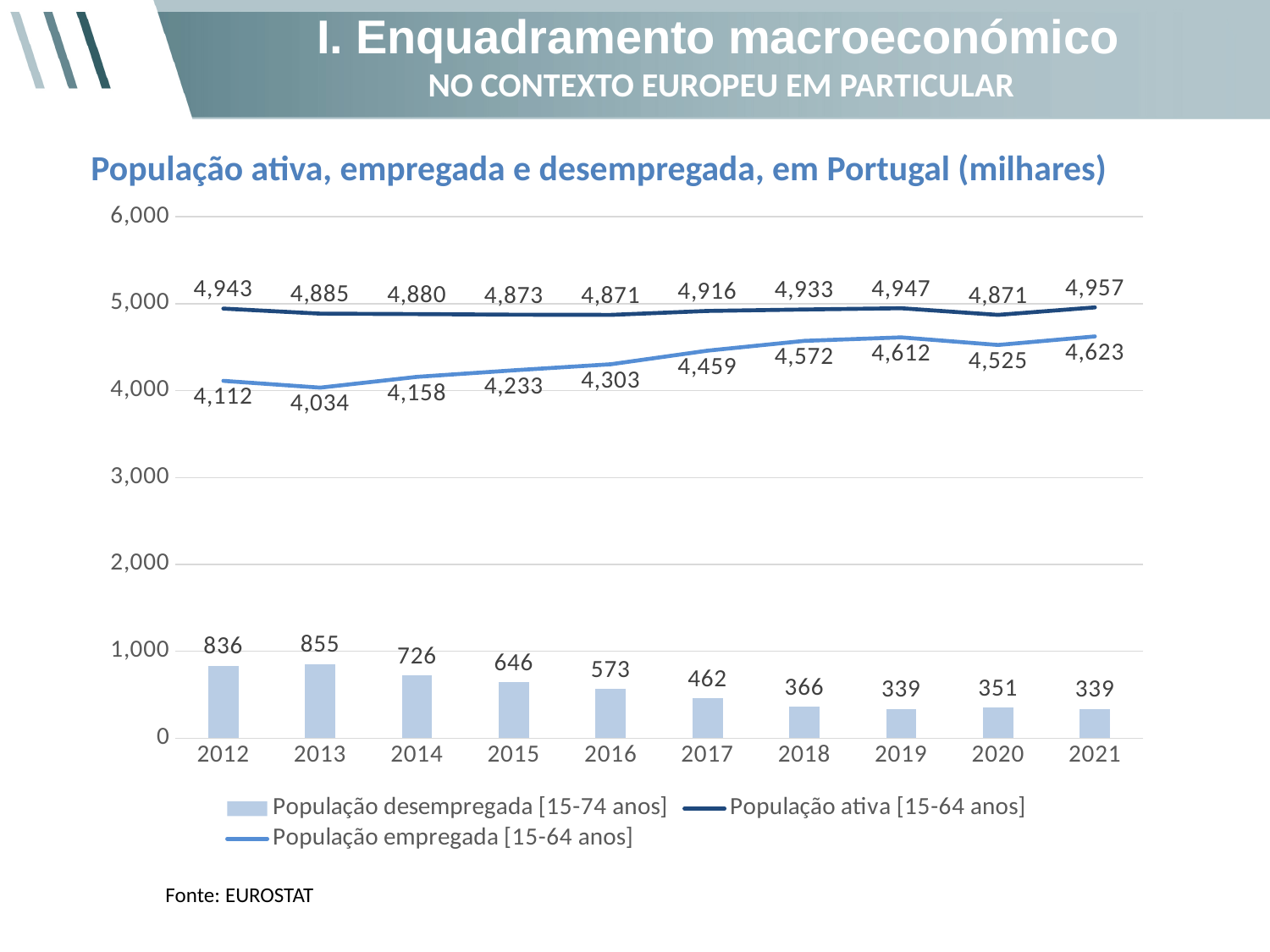
What is the source cited below the chart? EUROSTAT Which is larger: População desempregada [15-74 anos] in 2014 or in 2017? 2014 What kind of chart is this? Combined bar and line chart What is the value of População empregada [15-64 anos] in 2016? 4,303 Does População desempregada [15-74 anos] generally rise or fall from 2013 to 2019? Fall What is the difference between População ativa [15-64 anos] and População empregada [15-64 anos] in 2021? 334 What is the value of População desempregada [15-74 anos] in 2013? 855 In which year is População desempregada [15-74 anos] highest? 2013 What is the value of População ativa [15-64 anos] in 2021? 4,957 How many years are shown on the x axis? 10 In which year is População empregada [15-64 anos] lowest? 2013 How many series does the legend list? 3